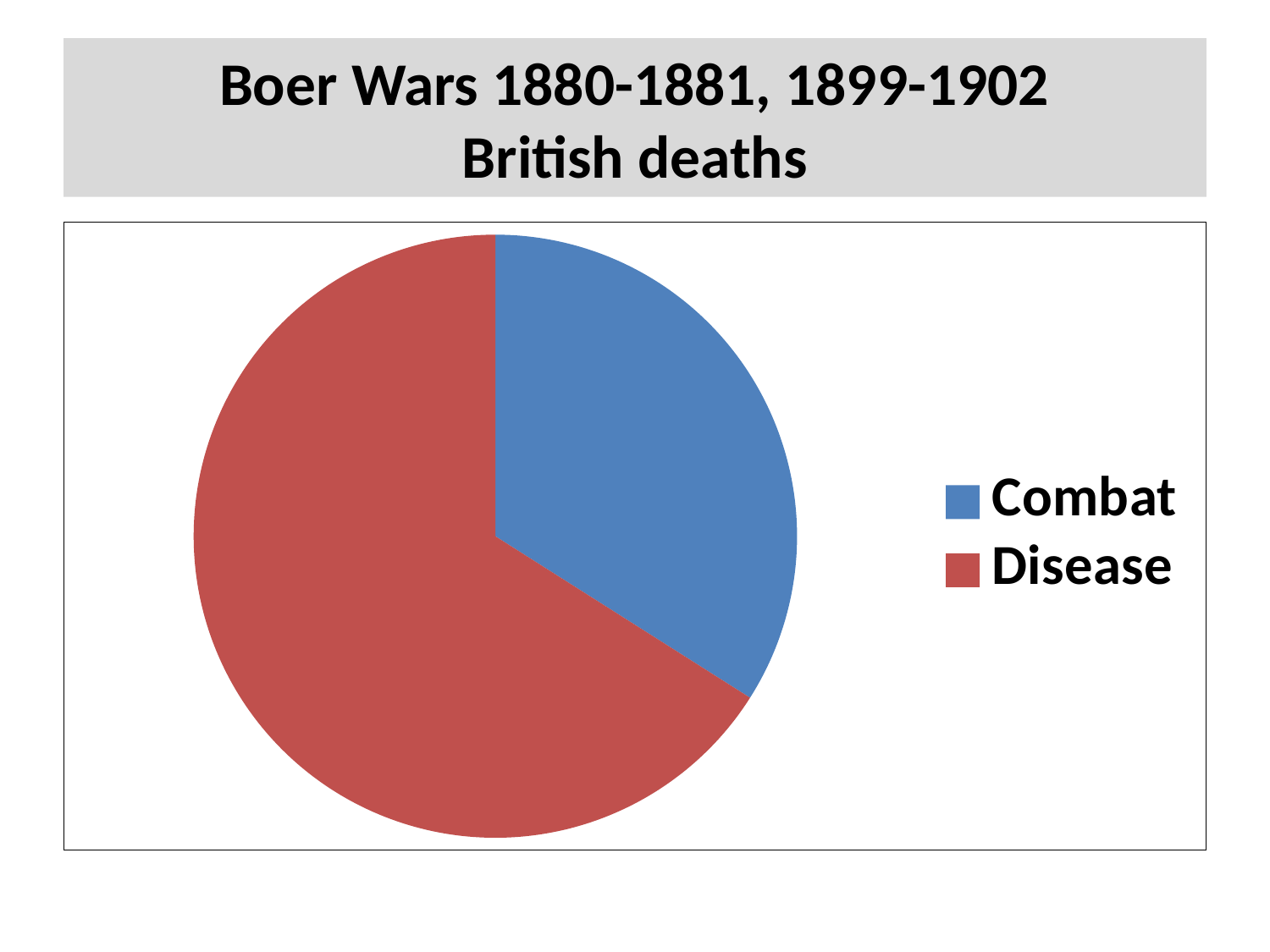
What is the title of the slide? Boer Wars 1880-1881, 1899-1902 British deaths Which category accounts for the largest share of British deaths? Disease How many slices does the pie chart have? 2 Is the Combat slice more or less than half of the pie? less Which is larger, the Combat slice or the Disease slice? Disease Is the Disease slice more or less than half of the pie? more What kind of chart is shown on the slide? pie chart What colour is the Disease slice? red Which category accounts for the smallest share of British deaths? Combat How many entries does the legend list? 2